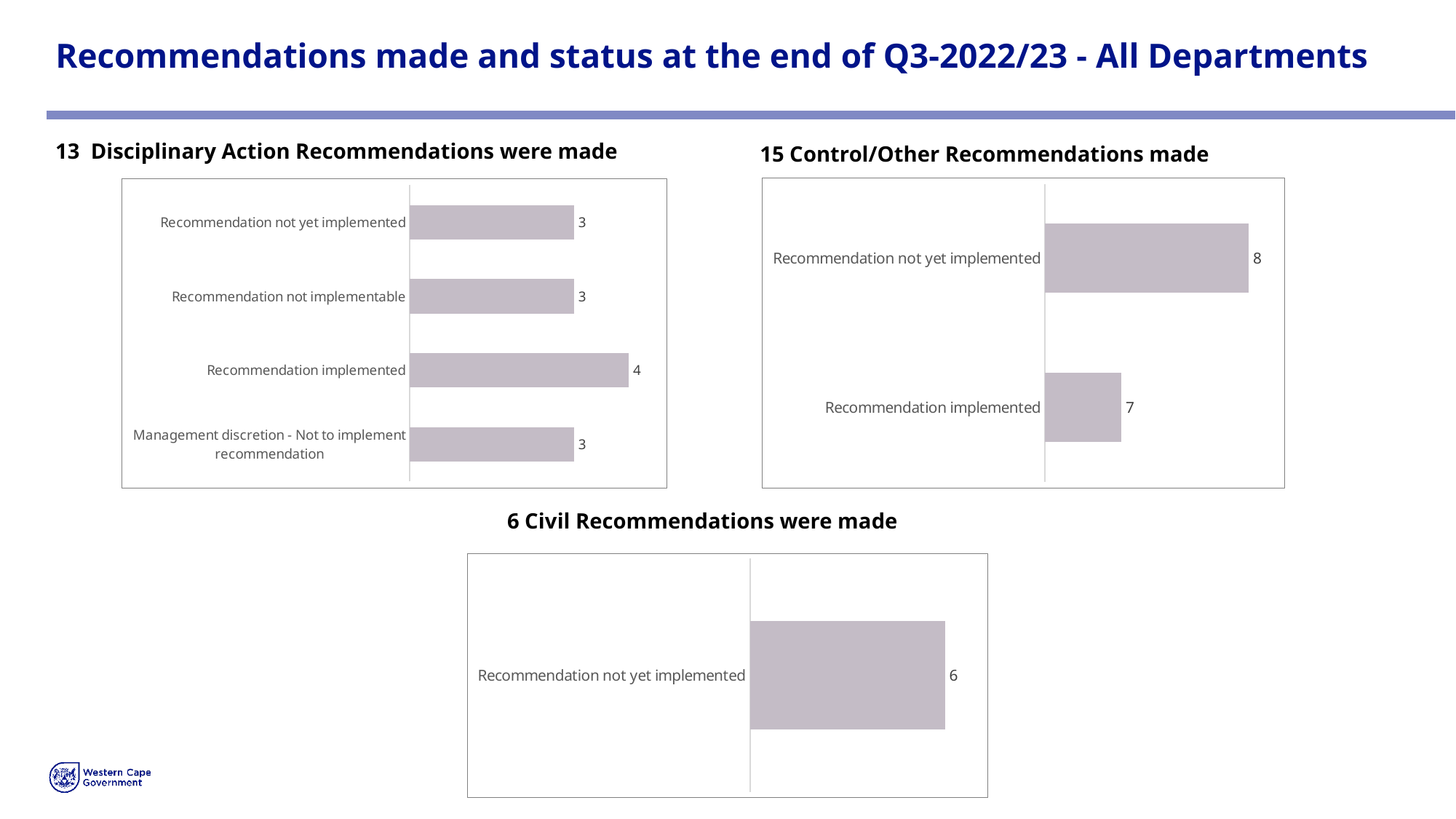
In the '15 Control/Other Recommendations made' chart, what is the value for 'Recommendation implemented'? 7 Which is larger: 'Recommendation implemented' in the Disciplinary Action chart or 'Recommendation implemented' in the Control/Other chart? Control/Other chart In the '13 Disciplinary Action Recommendations were made' chart, what is the value for 'Recommendation not implementable'? 3 In the '15 Control/Other Recommendations made' chart, what is the value for 'Recommendation not yet implemented'? 8 In the '6 Civil Recommendations were made' chart, what is the value for 'Recommendation not yet implemented'? 6 In the '13 Disciplinary Action Recommendations were made' chart, which category has the highest value? Recommendation implemented How many categories are shown in the '13 Disciplinary Action Recommendations were made' chart? 4 In the '15 Control/Other Recommendations made' chart, what is the difference between 'Recommendation not yet implemented' and 'Recommendation implemented'? 1 In the '15 Control/Other Recommendations made' chart, which category has the lowest value? Recommendation implemented What type of chart is the '6 Civil Recommendations were made' chart? Bar chart In the '13 Disciplinary Action Recommendations were made' chart, what is the value for 'Recommendation implemented'? 4 How many categories are shown in the '6 Civil Recommendations were made' chart? 1